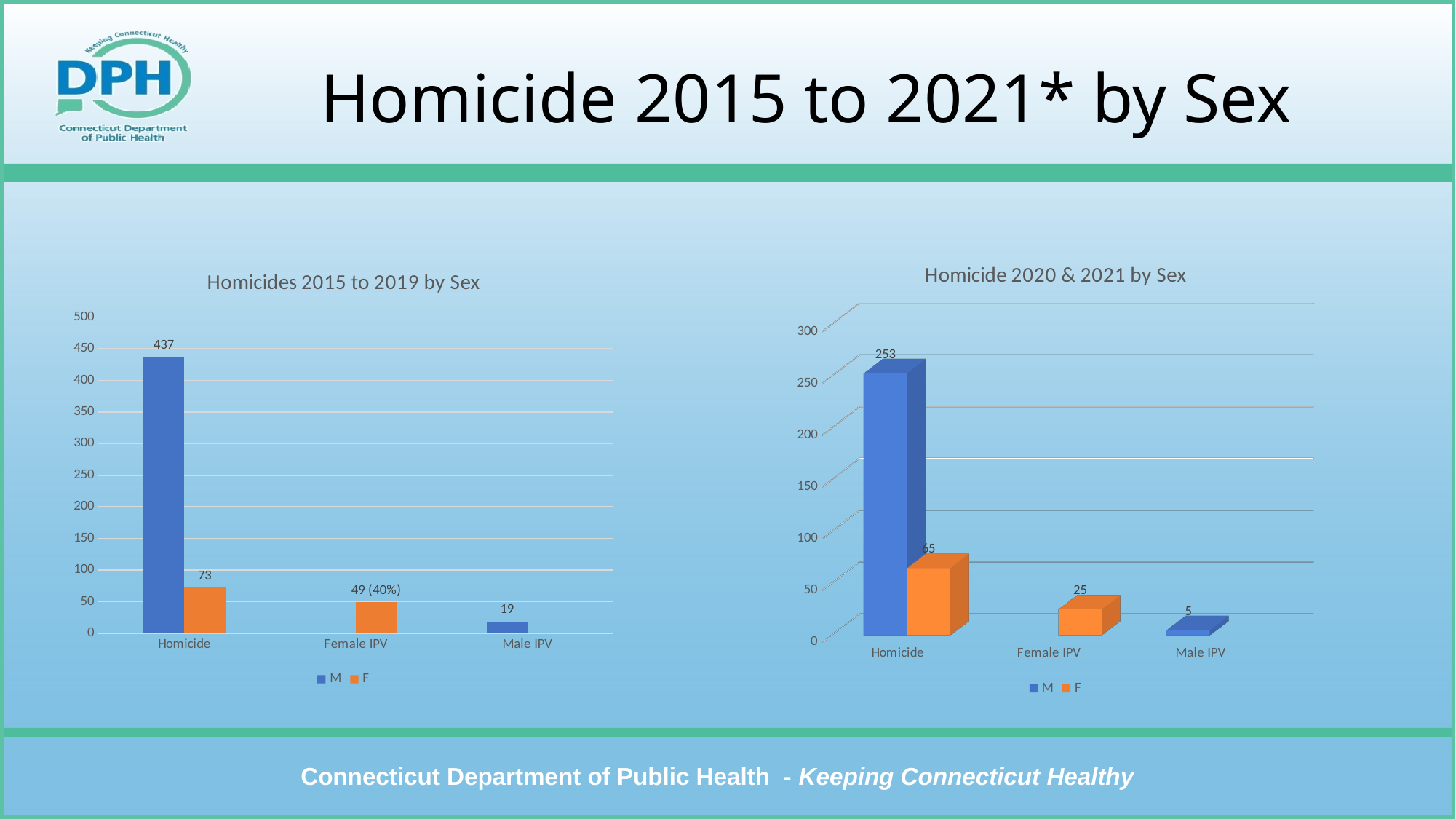
What kind of chart is the 'Homicide 2020 & 2021 by Sex' chart? Bar chart How many series does the legend list in the 'Homicides 2015 to 2019 by Sex' chart? 2 In the 'Homicides 2015 to 2019 by Sex' chart, what is the value for M in the Homicide category? 437 In the 'Homicides 2015 to 2019 by Sex' chart, what is the value for Male IPV? 19 In the 'Homicide 2020 & 2021 by Sex' chart, what is the value for F in the Homicide category? 65 In the 'Homicides 2015 to 2019 by Sex' chart, what is the difference between the M and F values in the Homicide category? 364 In the 'Homicide 2020 & 2021 by Sex' chart, what is the value for Male IPV? 5 In the 'Homicide 2020 & 2021 by Sex' chart, what is the value for Female IPV? 25 In the 'Homicides 2015 to 2019 by Sex' chart, what data label is shown on the Female IPV bar? 49 (40%) In the 'Homicide 2020 & 2021 by Sex' chart, which is larger, the Female IPV value or the Male IPV value? Female IPV In the 'Homicide 2020 & 2021 by Sex' chart, what is the value for M in the Homicide category? 253 In the 'Homicides 2015 to 2019 by Sex' chart, what is the value for F in the Homicide category? 73